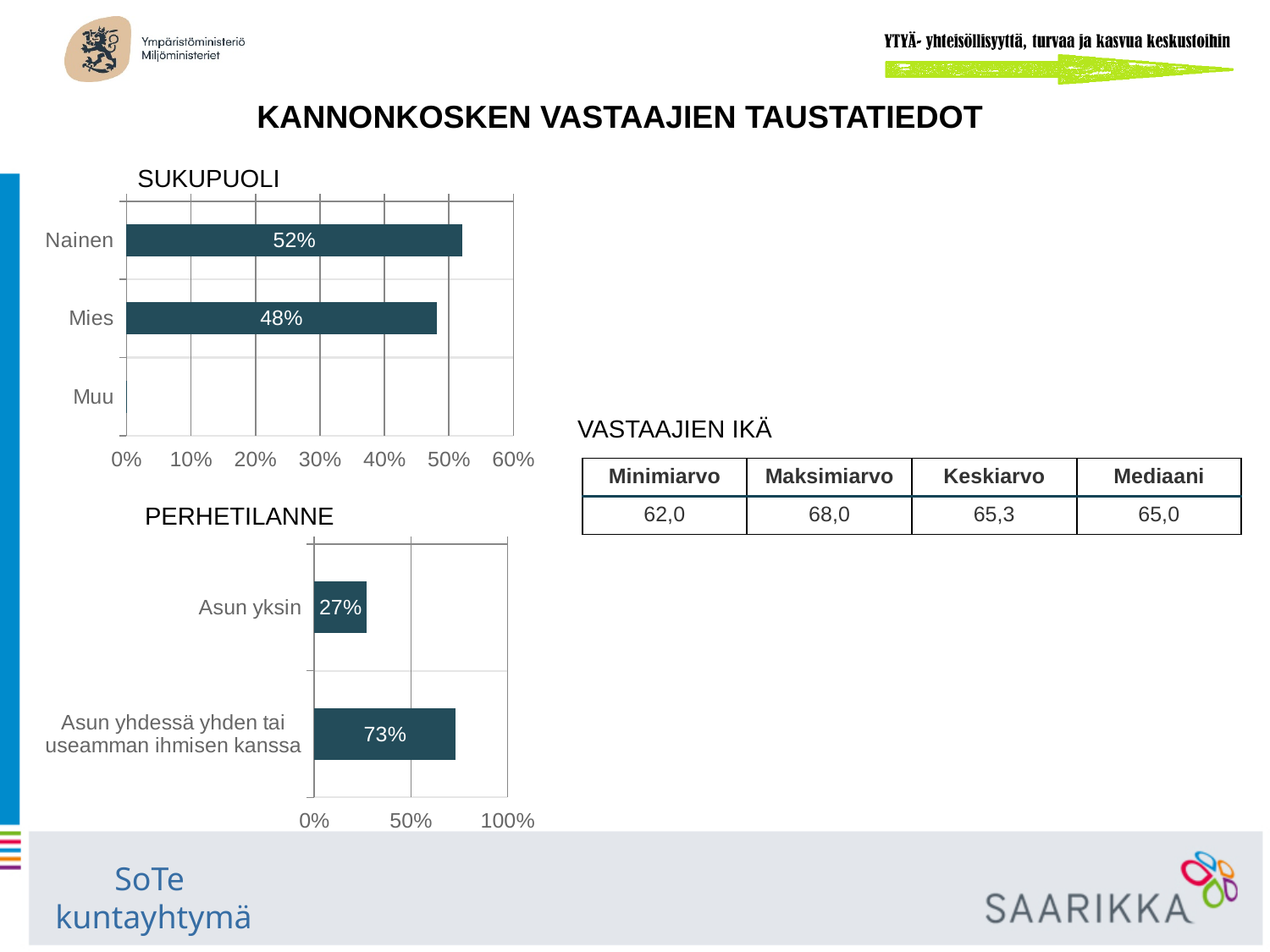
In the PERHETILANNE chart, what is the difference between the two categories' values? 46% In the PERHETILANNE chart, what is the value for Asun yhdessä yhden tai useamman ihmisen kanssa? 73% In the SUKUPUOLI chart, how many categories are shown on the axis? 3 In the SUKUPUOLI chart, is the value for Nainen greater or less than 50%? greater What kind of chart is the SUKUPUOLI chart? bar chart In the PERHETILANNE chart, is the value for Asun yksin greater or less than 50%? less In the SUKUPUOLI chart, what is the value for Mies? 48% In the SUKUPUOLI chart, what is the difference between the values for Nainen and Mies? 4% In the SUKUPUOLI chart, which category has the highest value? Nainen In the PERHETILANNE chart, which category has the lowest value? Asun yksin In the SUKUPUOLI chart, what is the value for Nainen? 52% In the PERHETILANNE chart, what is the value for Asun yksin? 27%